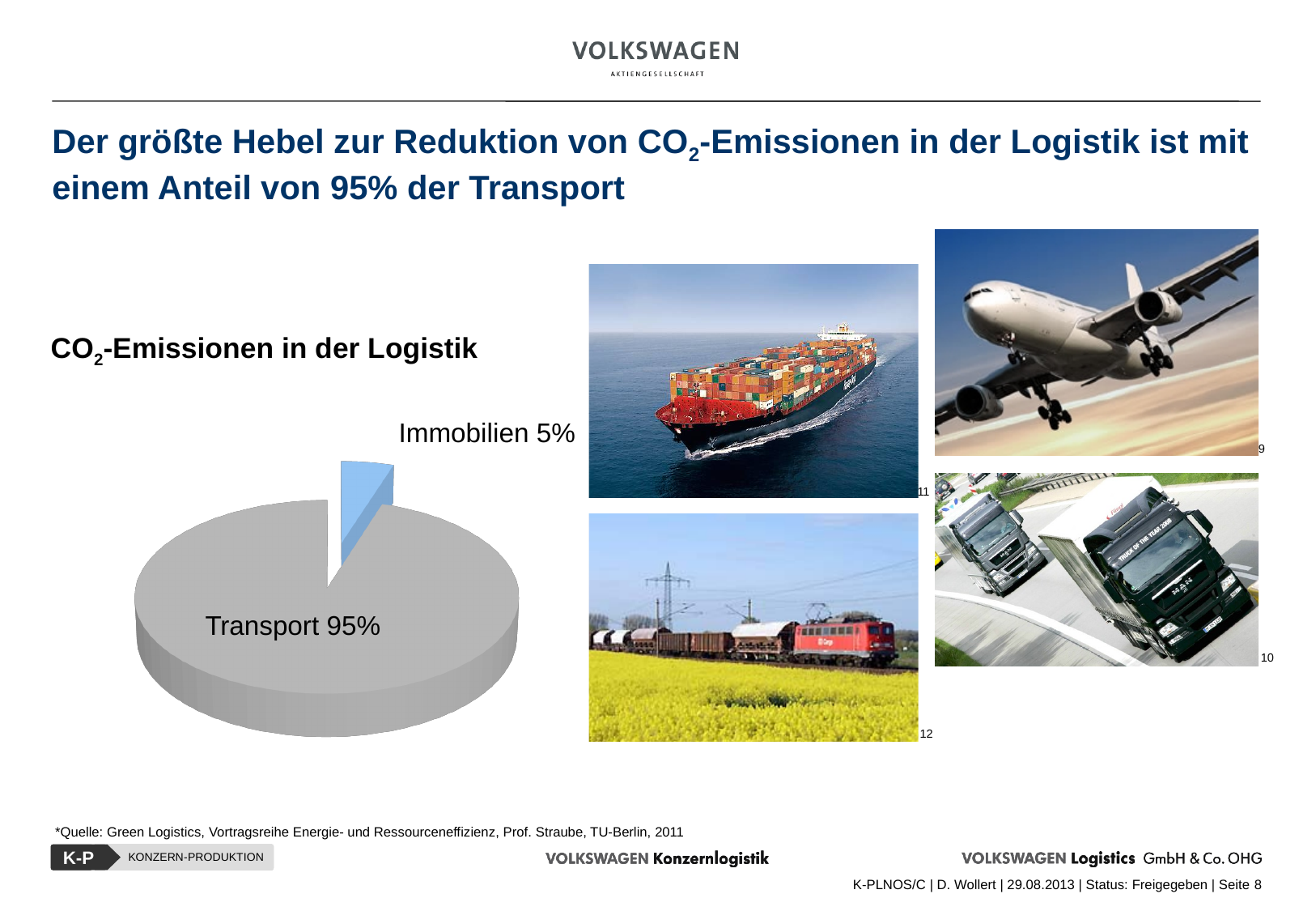
What is the difference in percentage points between the Transport and Immobilien shares? 90 What is the title of the chart? CO2-Emissionen in der Logistik Which category has the largest share of the pie? Transport Which category has the smallest share of the pie? Immobilien What colour is the Immobilien slice of the pie? Light blue What share of CO2 emissions in logistics does Immobilien account for? 5% What kind of chart is shown on the slide? Pie chart What share of CO2 emissions in logistics does Transport account for? 95% Which is larger, the share for Transport or the share for Immobilien? Transport How many categories are shown in the pie chart? 2 Is the share for Transport greater or less than 50%? greater